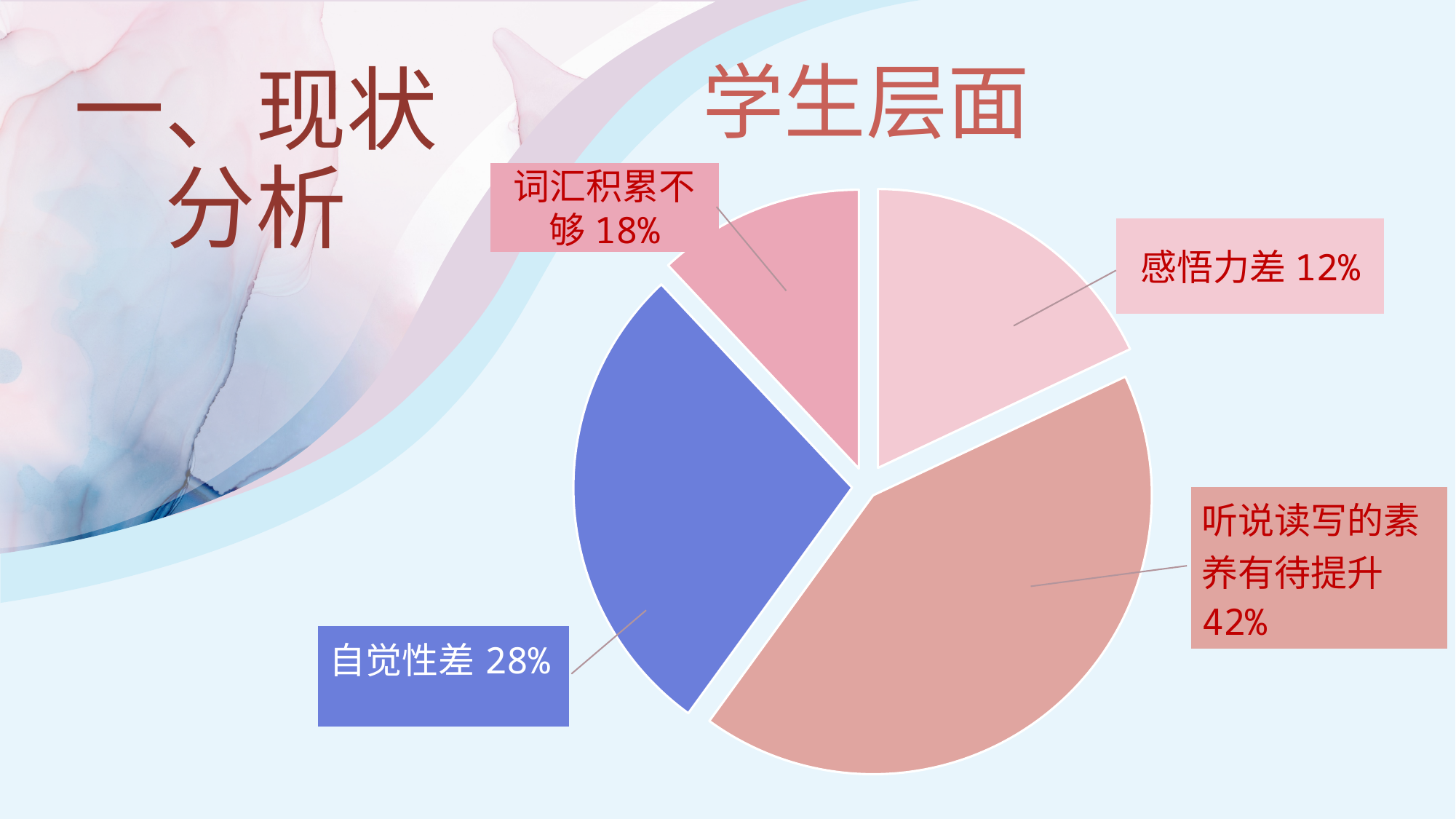
Which is larger, the share for 词汇积累不够 or the share for 感悟力差? 词汇积累不够 Which category has the smallest share of the pie? 感悟力差 What share of the pie is labelled 自觉性差? 28% Which category has the largest share of the pie? 听说读写的素养有待提升 How many slices does the pie chart have? 4 What share of the pie is labelled 词汇积累不够? 18% What kind of chart is shown on the slide? pie chart What is the title of the chart? 学生层面 What share of the pie is labelled 听说读写的素养有待提升? 42% What colour is the slice for 自觉性差? blue What share of the pie is labelled 感悟力差? 12% What is the difference in percentage points between 听说读写的素养有待提升 and 自觉性差? 14